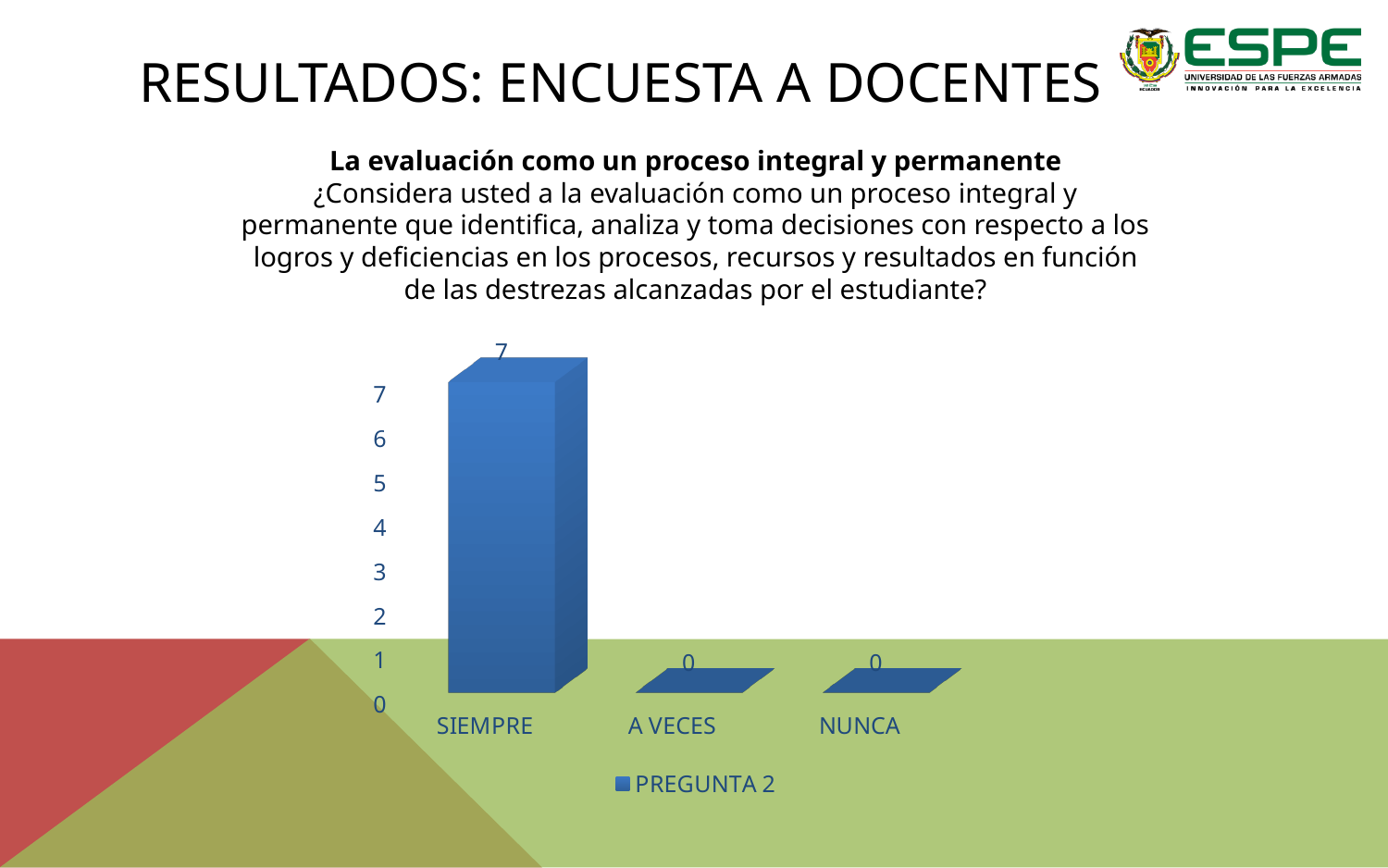
Which is larger, the value for SIEMPRE or the value for NUNCA? SIEMPRE What is the name of the series shown in the legend? PREGUNTA 2 Is the value for SIEMPRE greater or less than 5? greater What is the total of the values for SIEMPRE, A VECES and NUNCA? 7 What is the value for A VECES? 0 What kind of chart is shown on the slide? bar chart Which category has the highest value? SIEMPRE How many categories are shown on the x axis? 3 What is the difference between the values for SIEMPRE and A VECES? 7 What is the value for SIEMPRE? 7 What is the value for NUNCA? 0 How many series does the legend list? 1